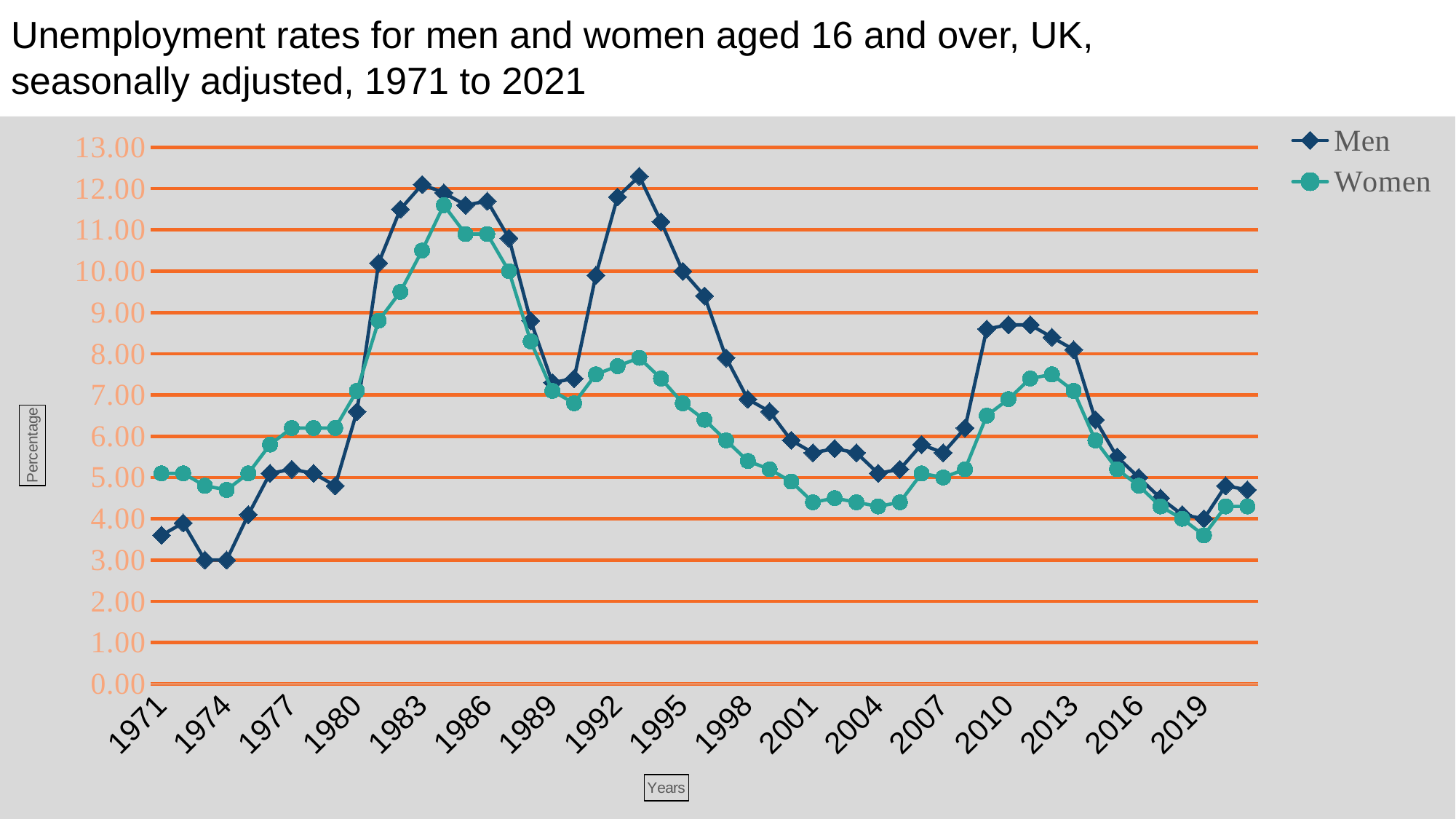
What kind of chart is shown on the slide? line chart How many series does the legend list? 2 Does the Men series rise or fall between 2011 and 2019? fall Is the value for Women in 1984 greater or less than 11.00? greater In which year does the Women series reach its highest value? 1984 Which series has the higher unemployment rate in 1993, Men or Women? Men Is the value for Men in 2011 greater or less than 8.00? greater Which series has the higher unemployment rate in 1977, Men or Women? Women Is the value for Men in 1971 greater or less than 4.00? less What is the label on the vertical axis? Percentage